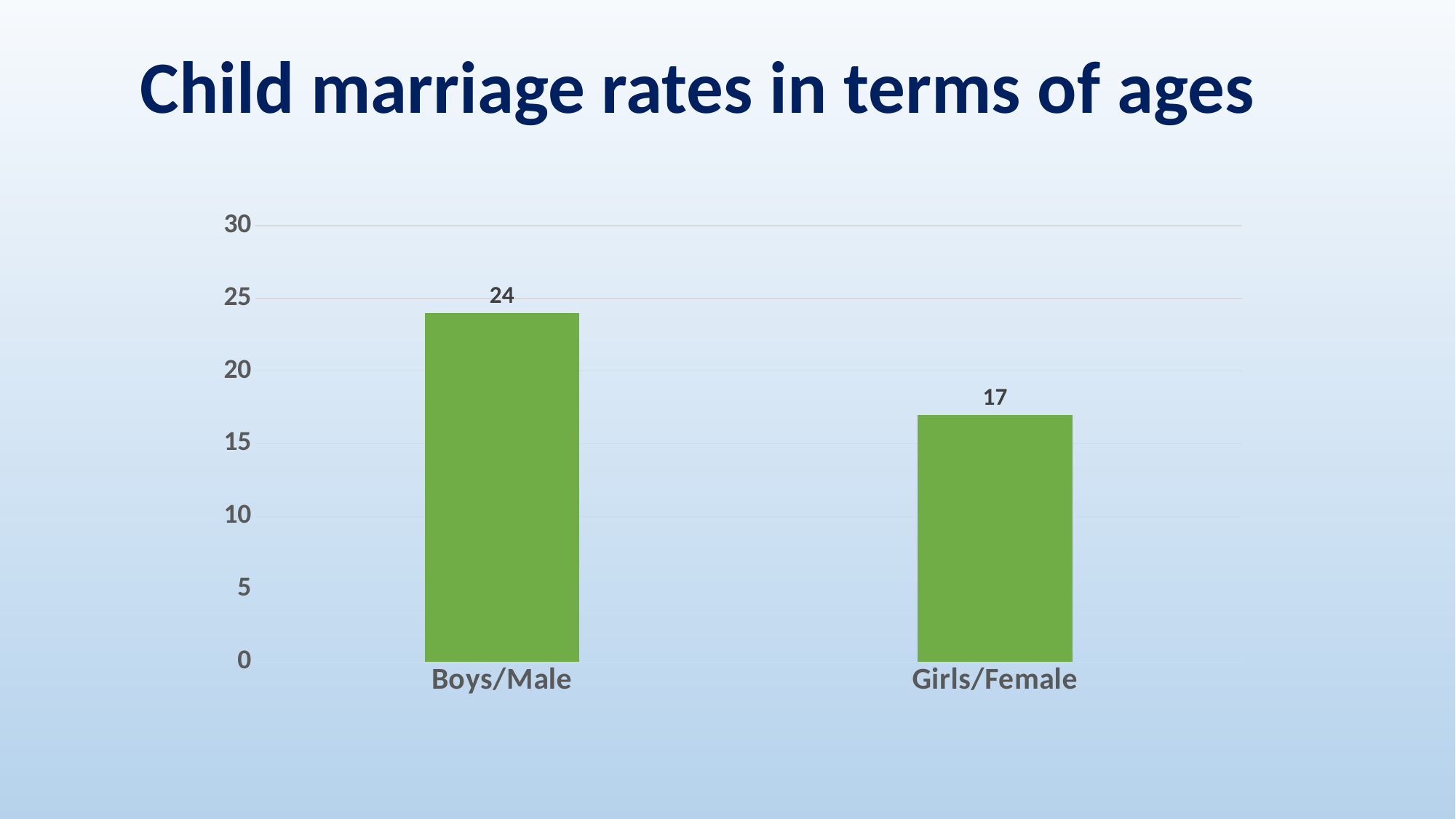
What kind of chart is shown on the slide? bar chart What is the value for Girls/Female? 17 Which category has the highest value? Boys/Male Is the value for Girls/Female greater or less than 20? less How many categories are shown on the chart? 2 Is the value for Boys/Male greater or less than 20? greater What is the difference between the values for Boys/Male and Girls/Female? 7 What is the title of the slide? Child marriage rates in terms of ages Which is larger, the value for Boys/Male or the value for Girls/Female? Boys/Male What is the value for Boys/Male? 24 What colour are the bars in the chart? green Which category has the lowest value? Girls/Female